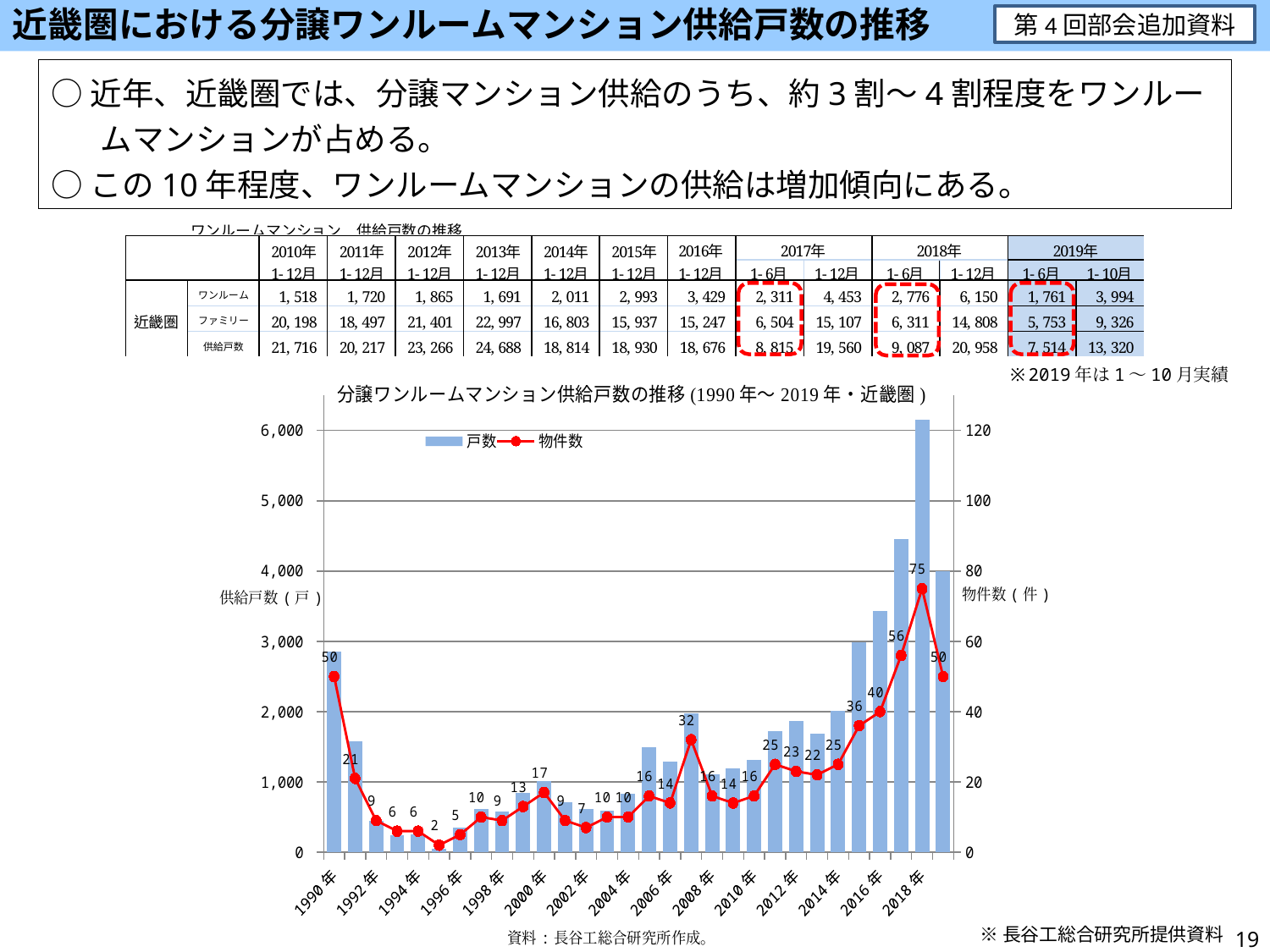
What is the 物件数 value for 2018 in the chart? 75 How many series does the chart legend list? 2 What is the 物件数 value for 1990 in the chart? 50 Which is larger, the 物件数 value for 2007 or for 2011? 2007 Is the 戸数 bar for 2017 greater or less than 4,000? greater What is the difference between the 物件数 values for 2018 and 2017? 19 Which year has the lowest 物件数 value in the chart? 1995年 What is the 物件数 value for 2007 in the chart? 32 Does the 物件数 line rise or fall from 2010 to 2018? Rise Which year has the highest 戸数 bar in the chart? 2018年 What kind of chart is shown on the slide? Combined bar and line chart Is the 戸数 bar for 2018 greater or less than 6,000? greater